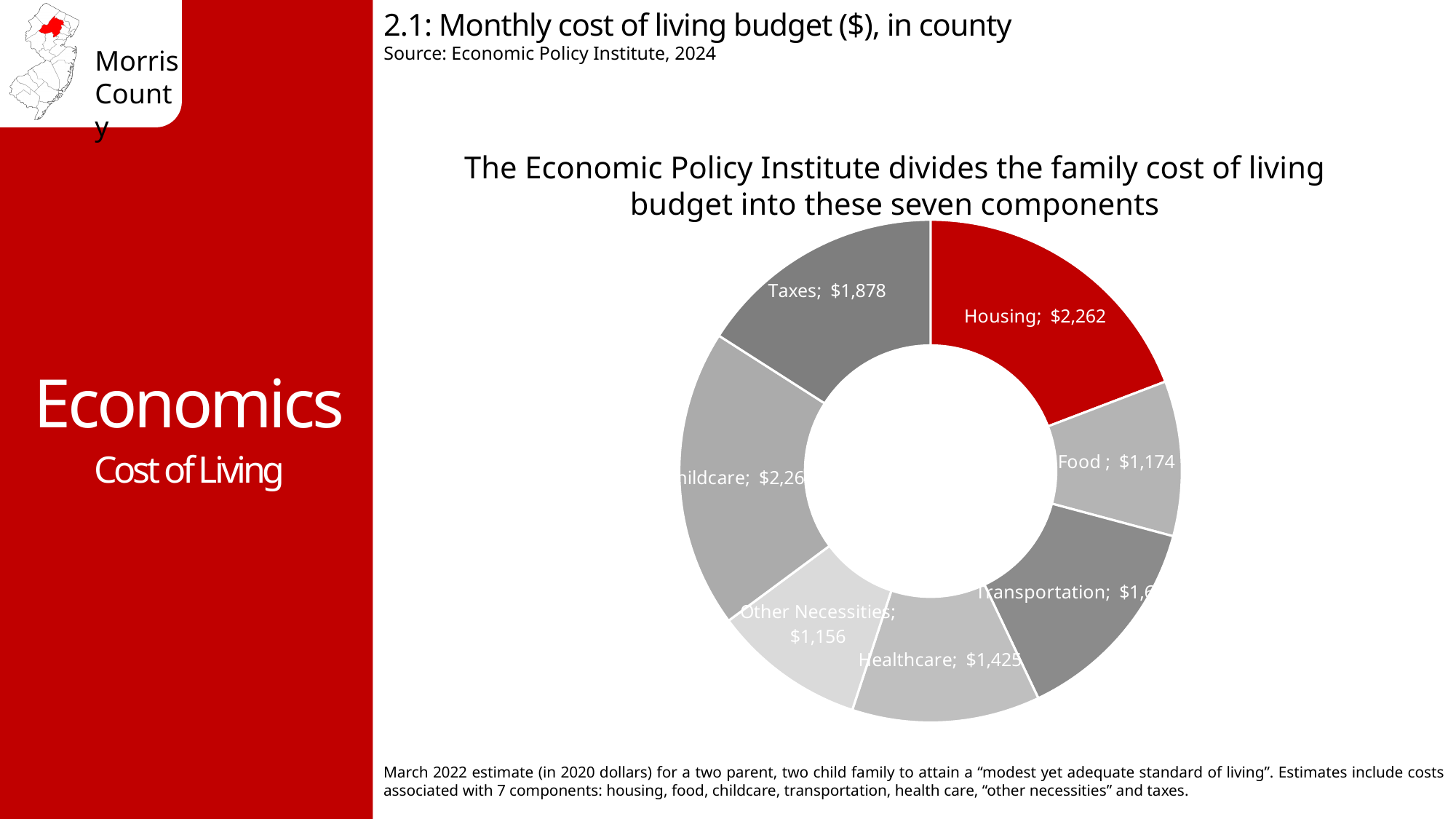
Which component has the lowest monthly cost in the chart? Other Necessities What kind of chart is shown on the slide? Doughnut chart How much larger is the Housing cost than the Taxes cost? $384 What is the difference between the Healthcare cost and the Food cost? $251 What is the monthly cost for Taxes in the chart? $1,878 Which is larger, the cost for Taxes or the cost for Healthcare? Taxes What is the monthly cost for Healthcare in the chart? $1,425 What is the monthly cost for Housing in the chart? $2,262 Which component is shown in red in the chart? Housing What is the monthly cost for Food in the chart? $1,174 How many components are shown in the chart? 7 What is the monthly cost for Other Necessities in the chart? $1,156